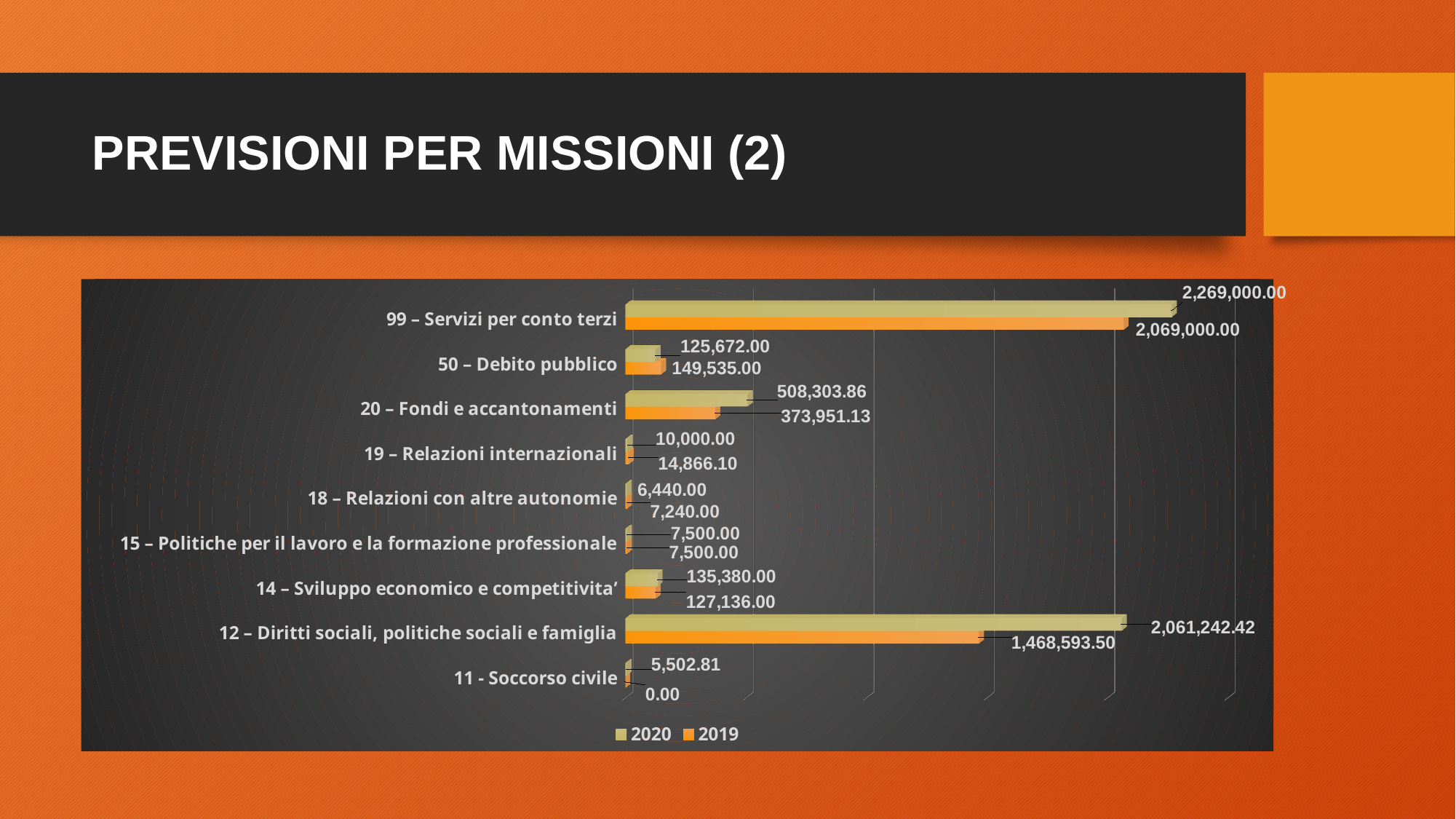
What is the 2020 value for 99 – Servizi per conto terzi? 2,269,000.00 How many categories are shown in the chart? 9 What is the difference between the 2020 and 2019 values for 12 – Diritti sociali, politiche sociali e famiglia? 592,648.92 What kind of chart is shown on the slide? Bar chart What is the 2020 value for 14 – Sviluppo economico e competitivita'? 135,380.00 What is the difference between the 2020 and 2019 values for 99 – Servizi per conto terzi? 200,000.00 Which category has the lowest 2019 value? 11 - Soccorso civile How many series does the legend list? 2 What is the 2019 value for 20 – Fondi e accantonamenti? 373,951.13 What is the 2019 value for 11 - Soccorso civile? 0.00 For 50 – Debito pubblico, which is larger: the 2020 value or the 2019 value? 2019 Which category has the highest 2020 value? 99 – Servizi per conto terzi